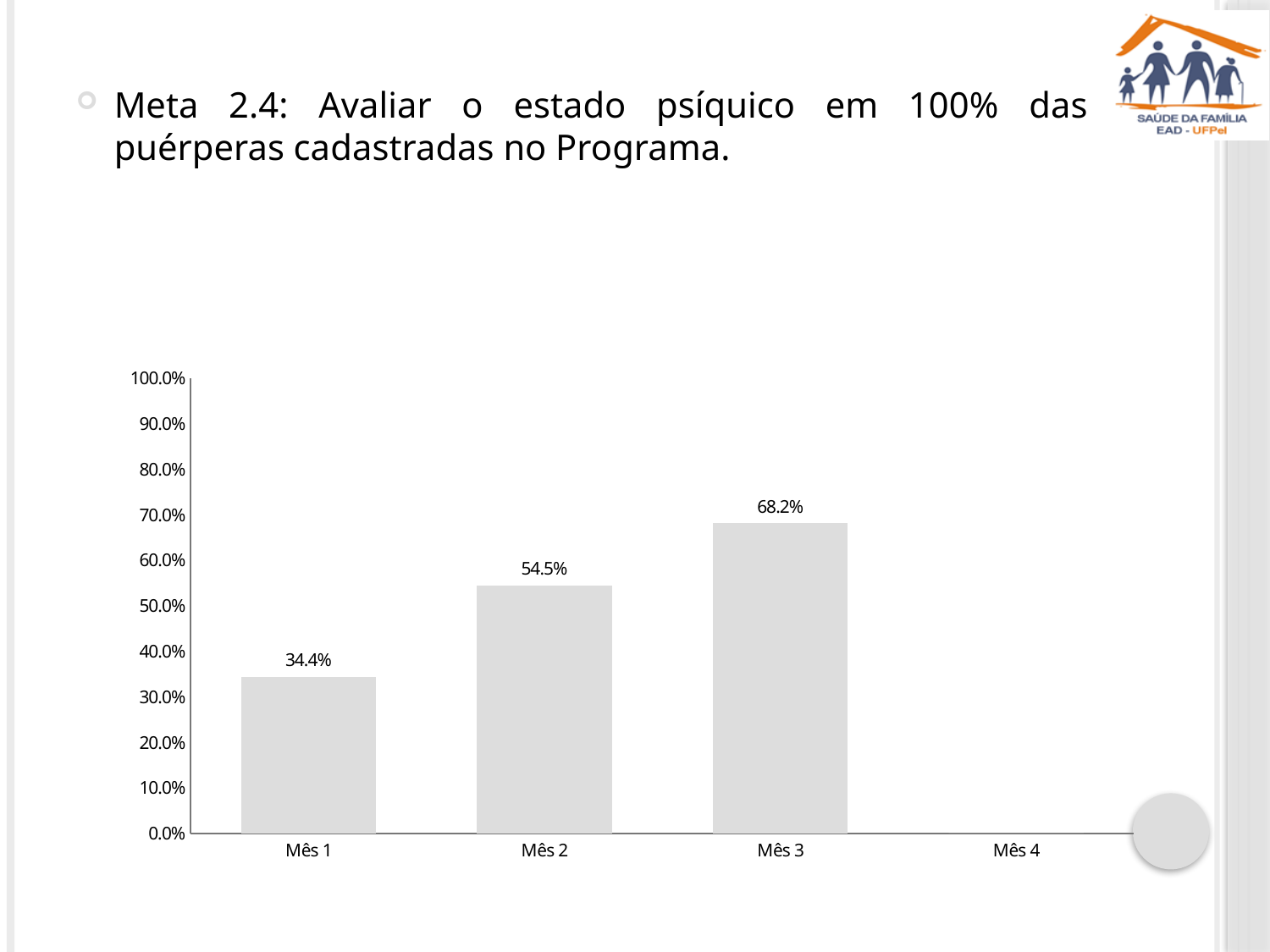
What is the value for Mês 3? 68.2% What is the difference between the values for Mês 3 and Mês 1? 33.8% Is the value for Mês 2 greater or less than 50.0%? greater What kind of chart is shown on the slide? bar chart Which is larger, the value for Mês 1 or the value for Mês 2? Mês 2 How many categories are shown on the x axis? 4 What is the difference between the values for Mês 2 and Mês 1? 20.1% Which month has the highest value? Mês 3 What is the value for Mês 2? 54.5% What is the value for Mês 1? 34.4% What is the difference between the values for Mês 3 and Mês 2? 13.7% Do the values rise or fall from Mês 1 to Mês 3? rise